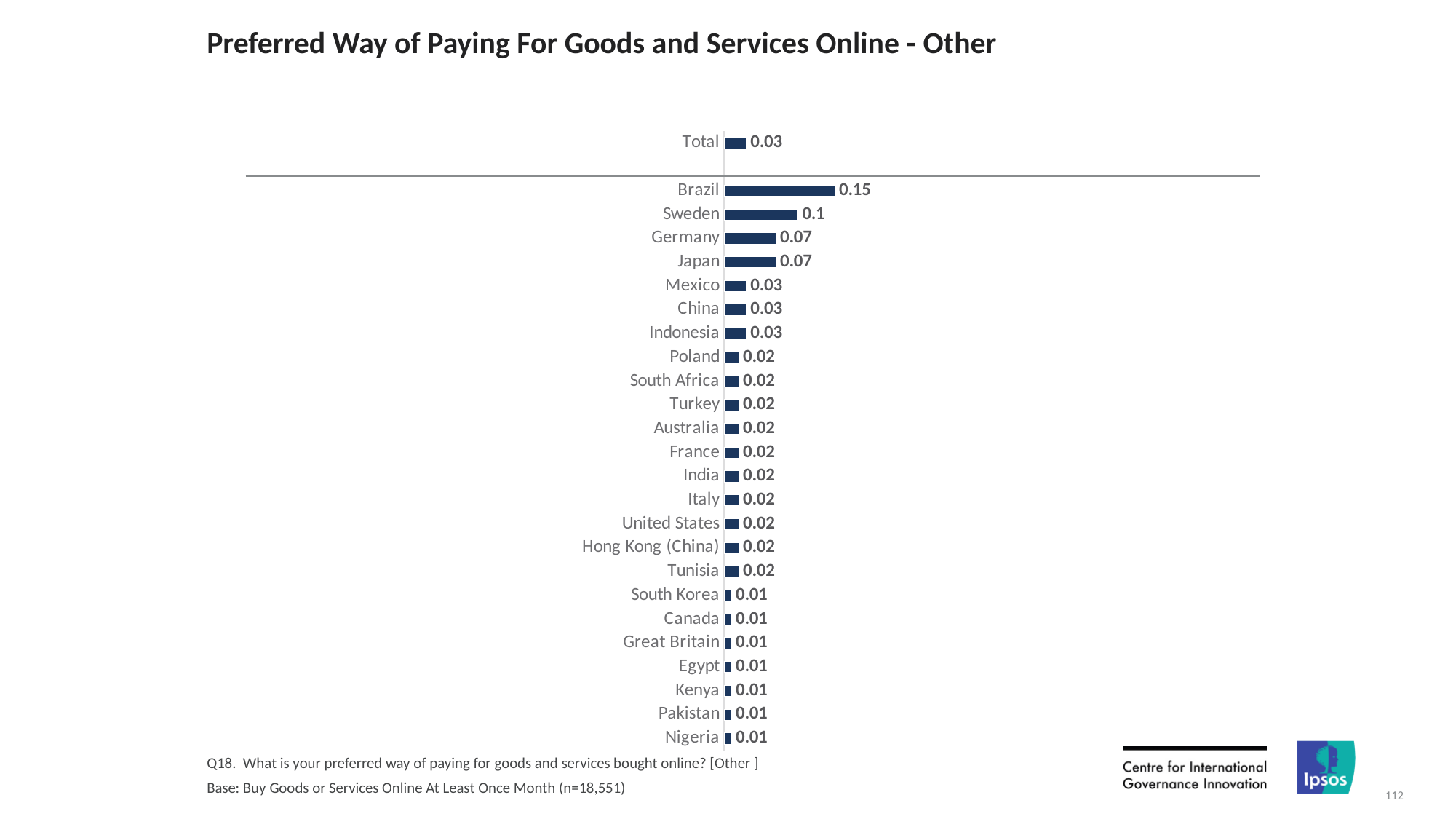
What is the difference between the values for Brazil and Sweden? 0.05 Which is larger, the value for Sweden or the value for Germany? Sweden What is the value for Nigeria? 0.01 What is the value for Japan? 0.07 What is the value for Sweden? 0.1 Which country has the highest value? Brazil What is the value for Brazil? 0.15 What is the value shown for Total? 0.03 What is the difference between the values for Germany and Mexico? 0.04 How many countries are listed below the Total bar? 24 Which is larger, the value for Poland or the value for Canada? Poland What kind of chart is shown on the slide? Bar chart